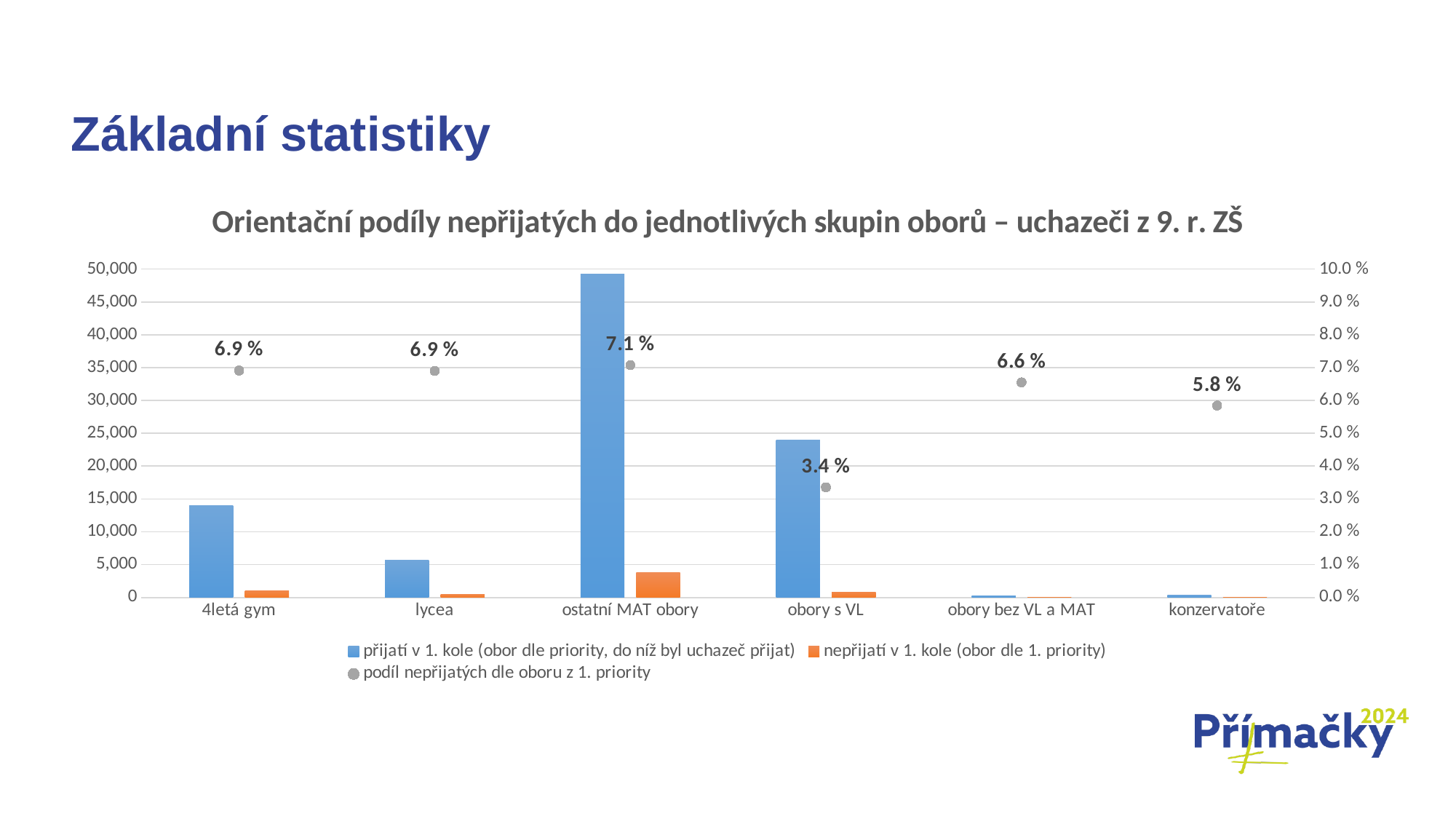
Which category has the tallest 'přijatí v 1. kole' bar? ostatní MAT obory Is the 'přijatí v 1. kole' value for '4letá gym' greater or less than 10,000? greater Which category has the highest 'podíl nepřijatých dle oboru z 1. priority'? ostatní MAT obory What is the value of 'podíl nepřijatých dle oboru z 1. priority' for 'konzervatoře'? 5.8 % Which has a larger 'podíl nepřijatých dle oboru z 1. priority': 'obory bez VL a MAT' or 'konzervatoře'? obory bez VL a MAT How many categories are shown on the x axis of the chart? 6 What is the value of 'podíl nepřijatých dle oboru z 1. priority' for 'obory s VL'? 3.4 % What is the difference between the 'podíl nepřijatých' values for 'obory bez VL a MAT' and 'konzervatoře'? 0.8 % Which category has the lowest 'podíl nepřijatých dle oboru z 1. priority'? obory s VL Is the 'přijatí v 1. kole' value for 'ostatní MAT obory' greater or less than 45,000? greater What is the value of 'podíl nepřijatých dle oboru z 1. priority' for 'ostatní MAT obory'? 7.1 % How many series does the chart legend list? 3